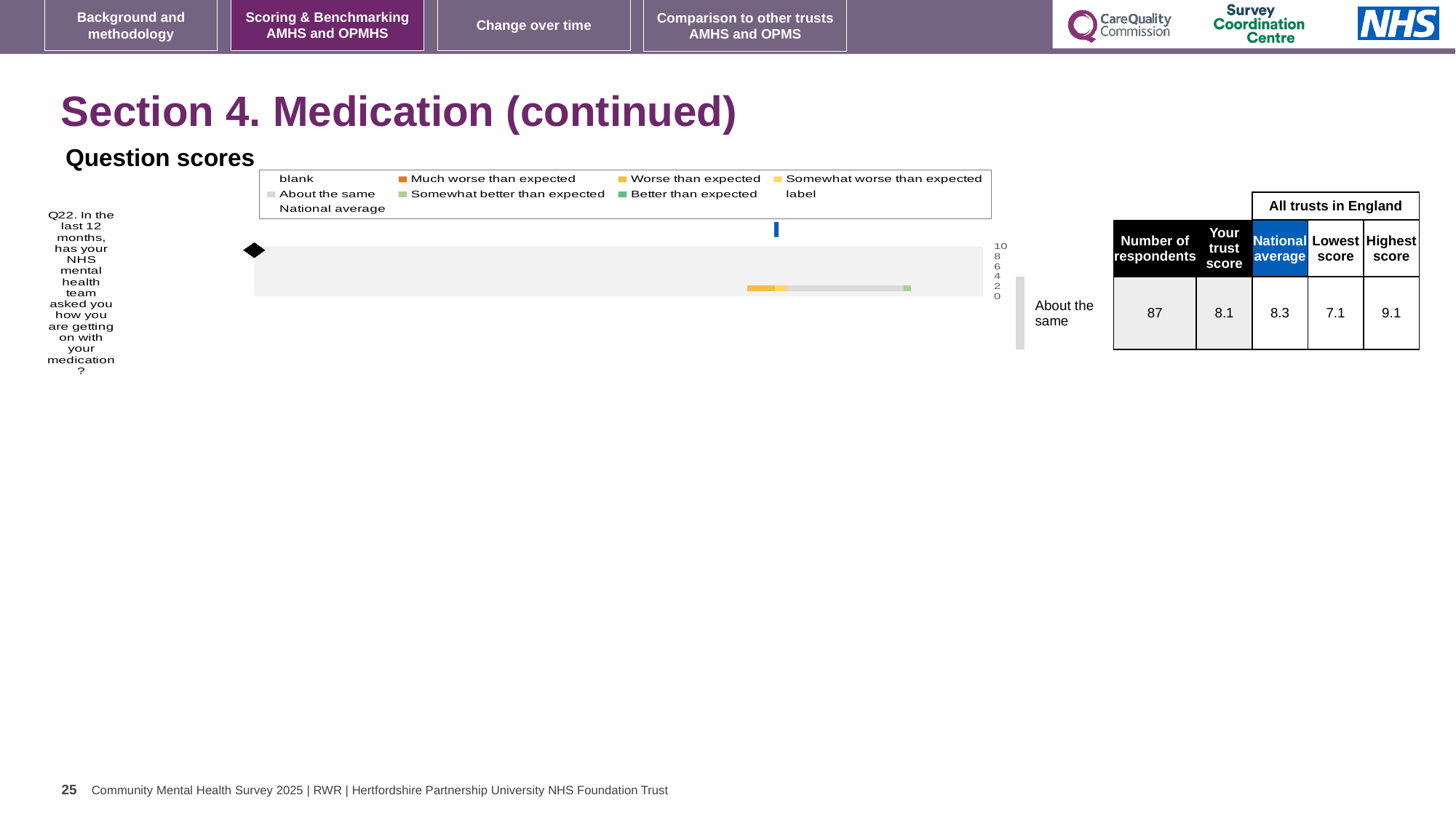
What is the lowest score among all trusts in England for Q22? 7.1 What is the national average for Q22 shown next to the Question scores chart? 8.3 For Q22, what is the difference between the highest score and the lowest score among all trusts in England? 2.0 What is the highest score among all trusts in England for Q22? 9.1 What is the maximum value shown on the score axis of the Question scores chart? 10 Which benchmark category is Q22 placed in on the Question scores chart? About the same What kind of chart is shown under 'Question scores'? bar chart How many survey questions are plotted in the Question scores chart? 1 What is the trust score for Q22 shown next to the Question scores chart? 8.1 For Q22, which is larger: the trust score or the national average? National average How many respondents answered Q22 according to the table beside the chart? 87 For Q22, how much higher is the national average than the trust score? 0.2